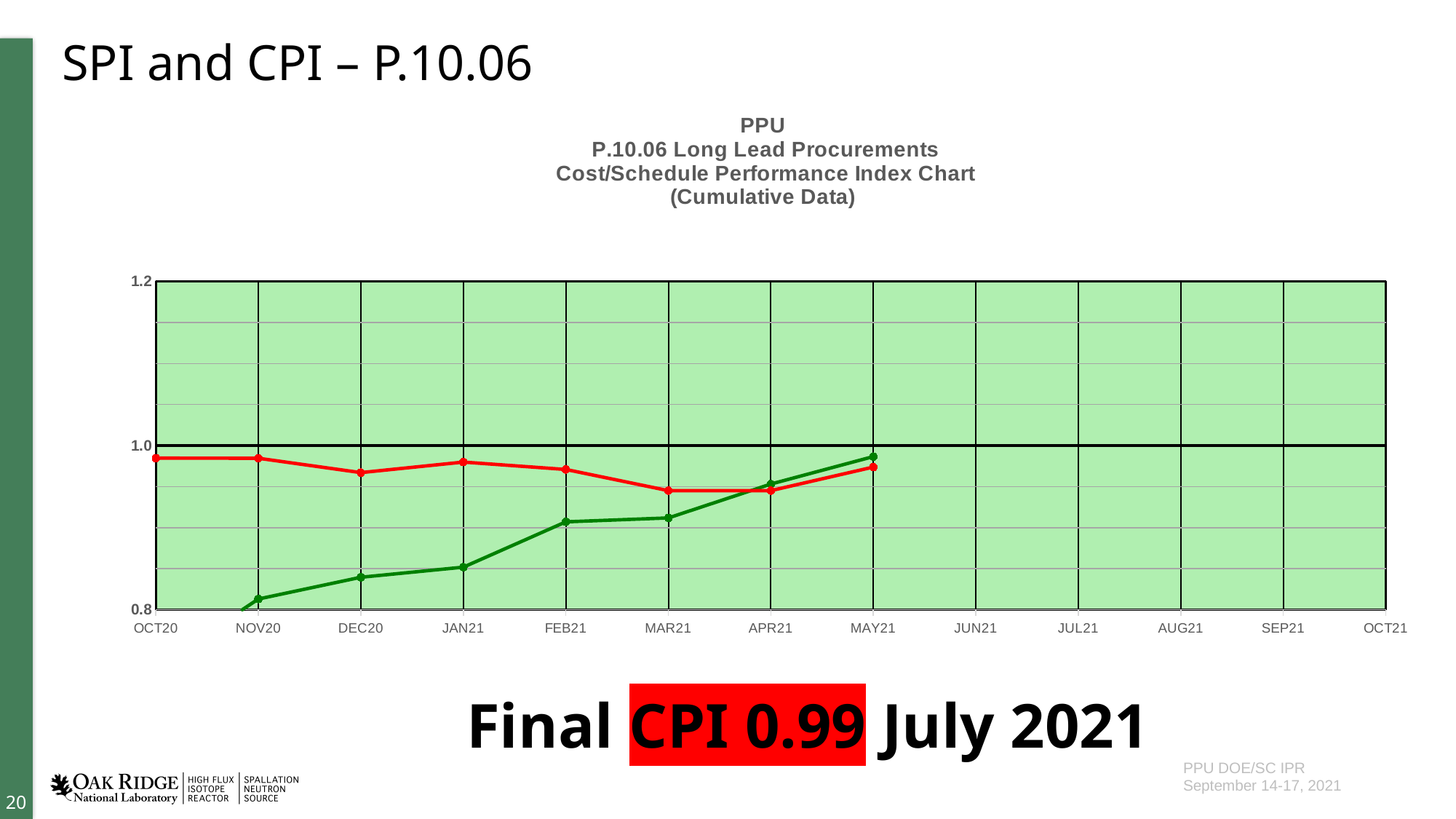
What is the first month label on the x axis of the chart? OCT20 Does the green line rise or fall from NOV20 to MAY21? Rise What is the highest value shown on the y axis of the chart? 1.2 Is the value of the green line at JAN21 greater or less than 0.9? less At MAY21, which line has the higher value, the red line or the green line? Green line What kind of chart is shown on the slide? Line chart Is the value of the red line at OCT20 greater or less than 1.0? less Is the value of the red line at MAR21 greater or less than 1.0? less At which month does the green line reach its highest plotted value? MAY21 How many month labels are shown along the x axis of the chart? 13 At JAN21, which line has the higher value, the red line or the green line? Red line